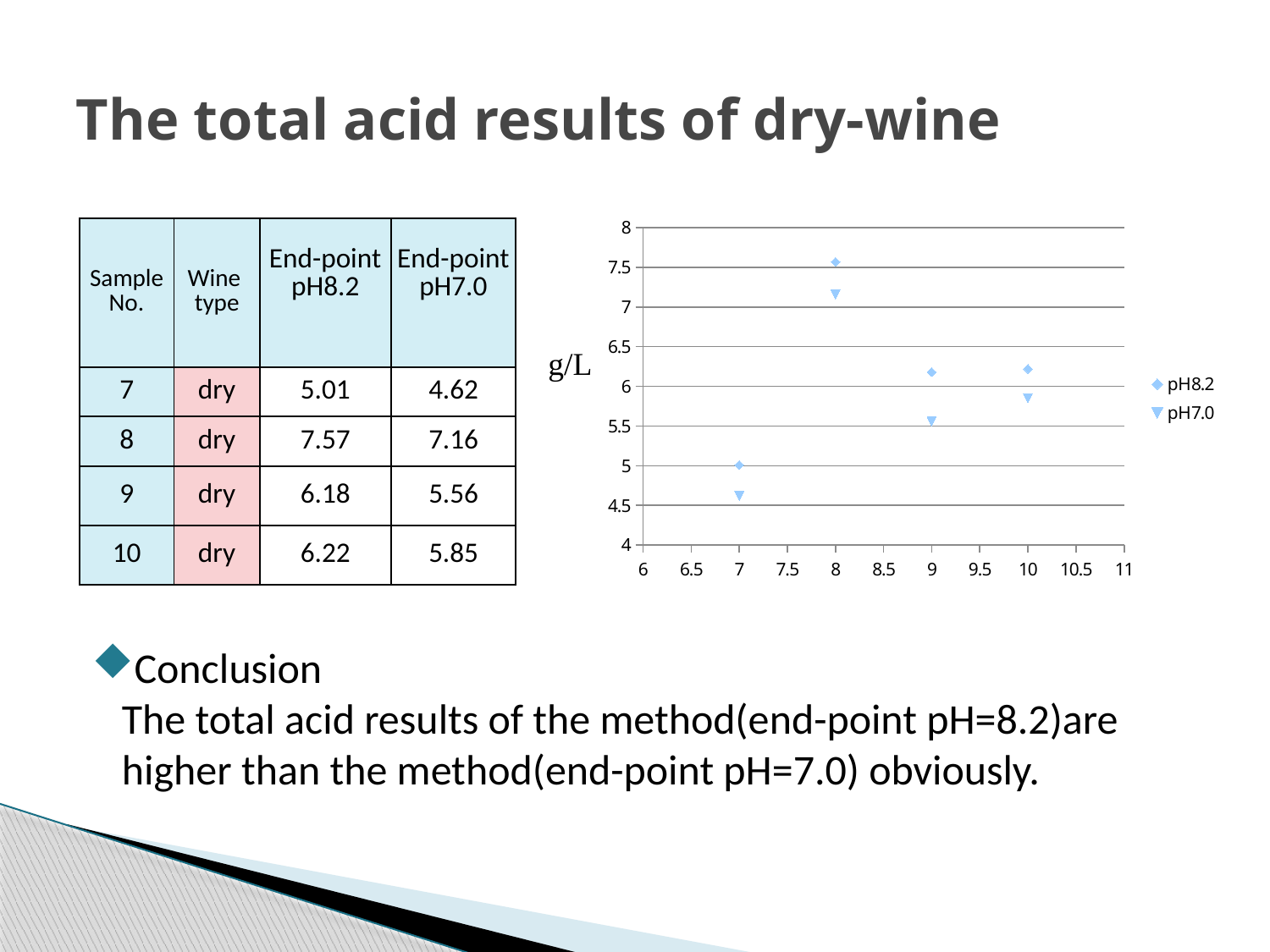
At sample 9, which series has the higher value, pH8.2 or pH7.0? pH8.2 What is the difference between the pH8.2 and pH7.0 values for sample 8? 0.41 Does the pH8.2 value rise or fall from sample 7 to sample 8? rise What unit label is shown on the y axis of the chart? g/L Is the pH7.0 value for sample 7 greater or less than 5? less How many series does the chart legend list? 2 How many data points are plotted for the pH8.2 series? 4 What kind of chart is shown on the slide? scatter chart Which sample number has the lowest pH7.0 value in the chart? 7 Is the pH8.2 value for sample 8 greater or less than 7? greater What is the end-point pH8.2 total acid value for sample 8? 7.57 Which sample number has the highest pH8.2 value in the chart? 8